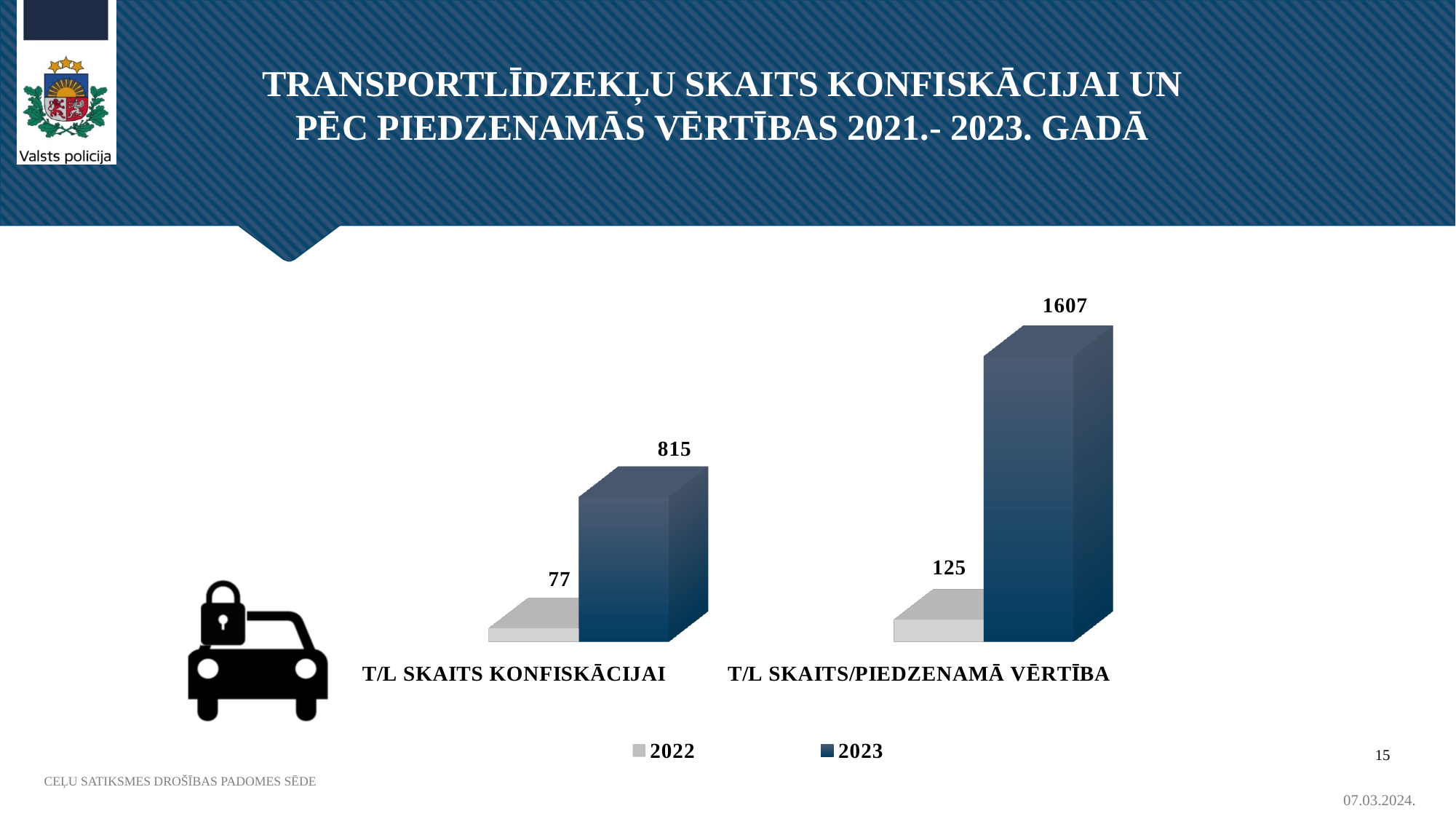
What is the 2023 value for T/L SKAITS KONFISKĀCIJAI? 815 How many series does the legend list? 2 What is the 2022 value for T/L SKAITS/PIEDZENAMĀ VĒRTĪBA? 125 Which is larger: the 2023 value for T/L SKAITS KONFISKĀCIJAI or the 2023 value for T/L SKAITS/PIEDZENAMĀ VĒRTĪBA? T/L SKAITS/PIEDZENAMĀ VĒRTĪBA How many categories are shown on the x axis? 2 What is the difference between the 2023 and 2022 values for T/L SKAITS KONFISKĀCIJAI? 738 What kind of chart is shown on the slide? Bar chart Which bar has the highest value on the chart? 2023, T/L SKAITS/PIEDZENAMĀ VĒRTĪBA What is the 2022 value for T/L SKAITS KONFISKĀCIJAI? 77 What is the 2023 value for T/L SKAITS/PIEDZENAMĀ VĒRTĪBA? 1607 What is the difference between the 2023 and 2022 values for T/L SKAITS/PIEDZENAMĀ VĒRTĪBA? 1482 Which bar has the lowest value on the chart? 2022, T/L SKAITS KONFISKĀCIJAI